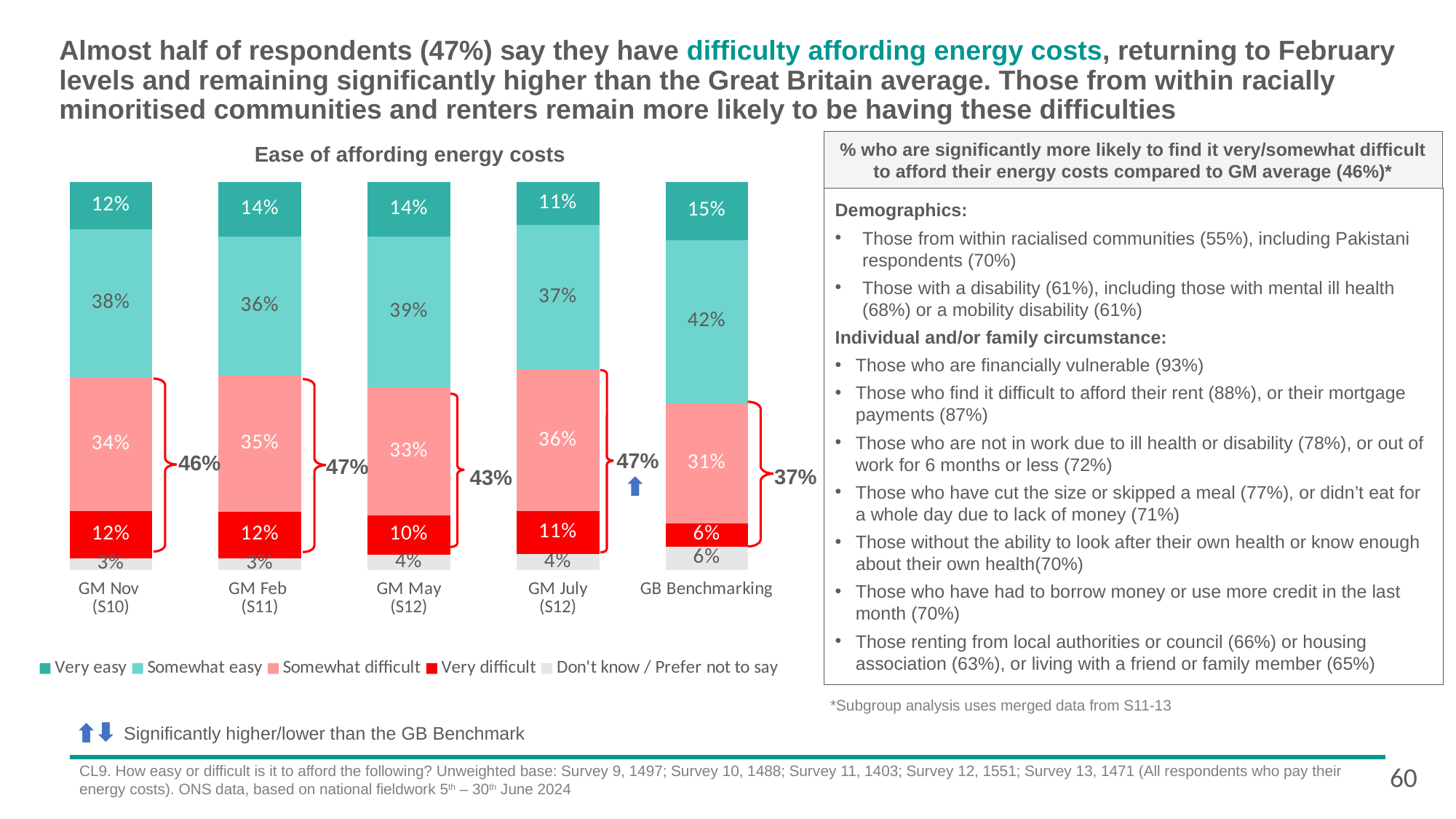
What is the 'Very easy' value for GM July (S12)? 11% How many categories are shown along the x axis of the chart? 5 What is the 'Very difficult' value for GM May (S12)? 10% What is the 'Somewhat easy' value for GB Benchmarking? 42% Which category has the lowest 'Very difficult' value? GB Benchmarking Which is larger: the 'Very easy' value for GM Nov (S10) or for GB Benchmarking? GB Benchmarking What is the difference between the 'Somewhat easy' values for GB Benchmarking and GM Feb (S11)? 6% Which category has the highest 'Somewhat difficult' value? GM July (S12) Which legend entry is shown in red? Very difficult How many series does the chart legend list? 5 What is the combined 'Somewhat difficult' plus 'Very difficult' share labelled for GM May (S12)? 43% What type of chart is shown under the title 'Ease of affording energy costs'? Stacked bar chart